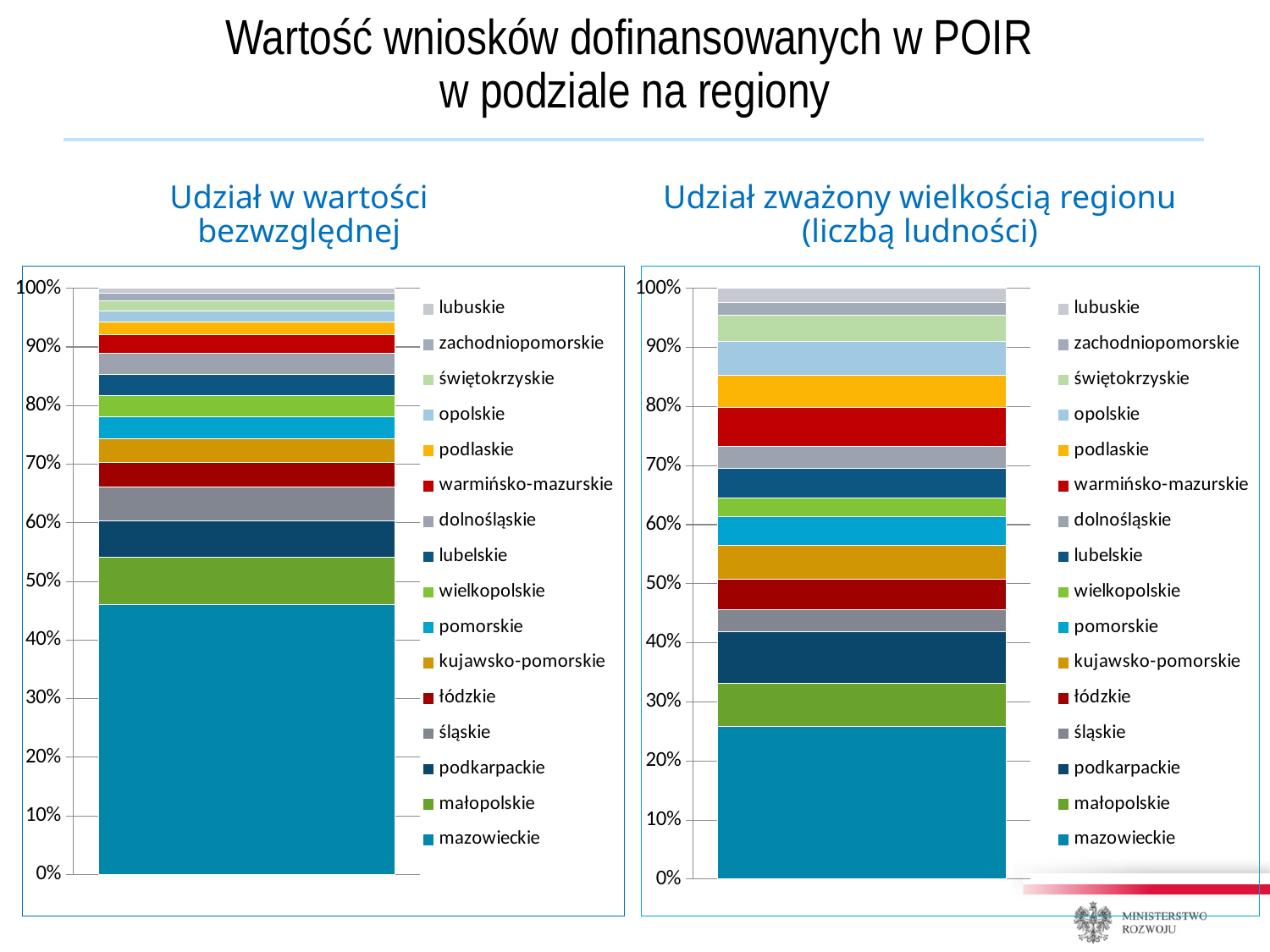
What type of chart is the left chart titled 'Udział w wartości bezwzględnej'? stacked bar chart Is the mazowieckie segment larger in the left chart or in the right chart? left chart In the right chart 'Udział zważony wielkością regionu (liczbą ludności)', which segment is larger: mazowieckie or podkarpackie? mazowieckie What is the title of the right chart? Udział zważony wielkością regionu (liczbą ludności) In the right chart 'Udział zważony wielkością regionu (liczbą ludności)', which region has the largest segment? mazowieckie How many regions does the legend of the left chart 'Udział w wartości bezwzględnej' list? 16 In the right chart 'Udział zważony wielkością regionu (liczbą ludności)', is the share for mazowieckie greater or less than 30%? less In the left chart 'Udział w wartości bezwzględnej', is the share for mazowieckie greater or less than 40%? greater In the right chart 'Udział zważony wielkością regionu (liczbą ludności)', is the share for mazowieckie greater or less than 20%? greater In the left chart 'Udział w wartości bezwzględnej', which region has the largest segment? mazowieckie How many stacked bars does the left chart 'Udział w wartości bezwzględnej' contain? 1 In the left chart 'Udział w wartości bezwzględnej', which segment is larger: mazowieckie or małopolskie? mazowieckie